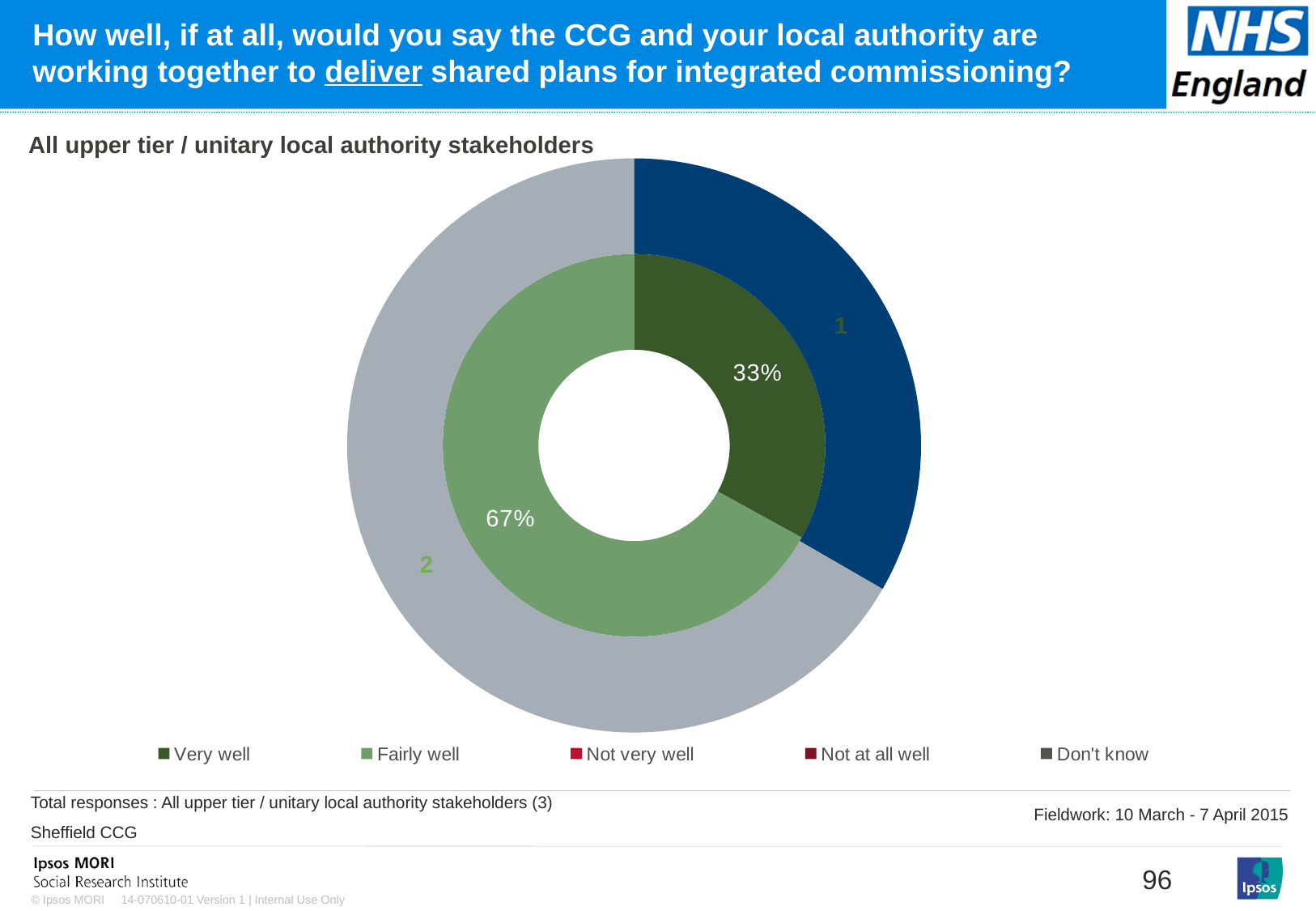
What is the difference in percentage points between 'Fairly well' and 'Very well'? 34 How many respondents answered 'Fairly well', according to the outer ring? 2 How many response categories does the legend list? 5 Which response category has the largest share of the chart? Fairly well Which CCG does this chart relate to? Sheffield CCG What percentage of respondents said the CCG and local authority are working together 'Very well'? 33% What type of chart is shown on the slide? Doughnut chart What is the total number of responses stated on the slide? 3 How many respondents answered 'Very well', according to the outer ring? 1 What is the subtitle above the chart describing the respondent group? All upper tier / unitary local authority stakeholders Which is larger, the share for 'Very well' or the share for 'Fairly well'? Fairly well What percentage of respondents said 'Fairly well'? 67%